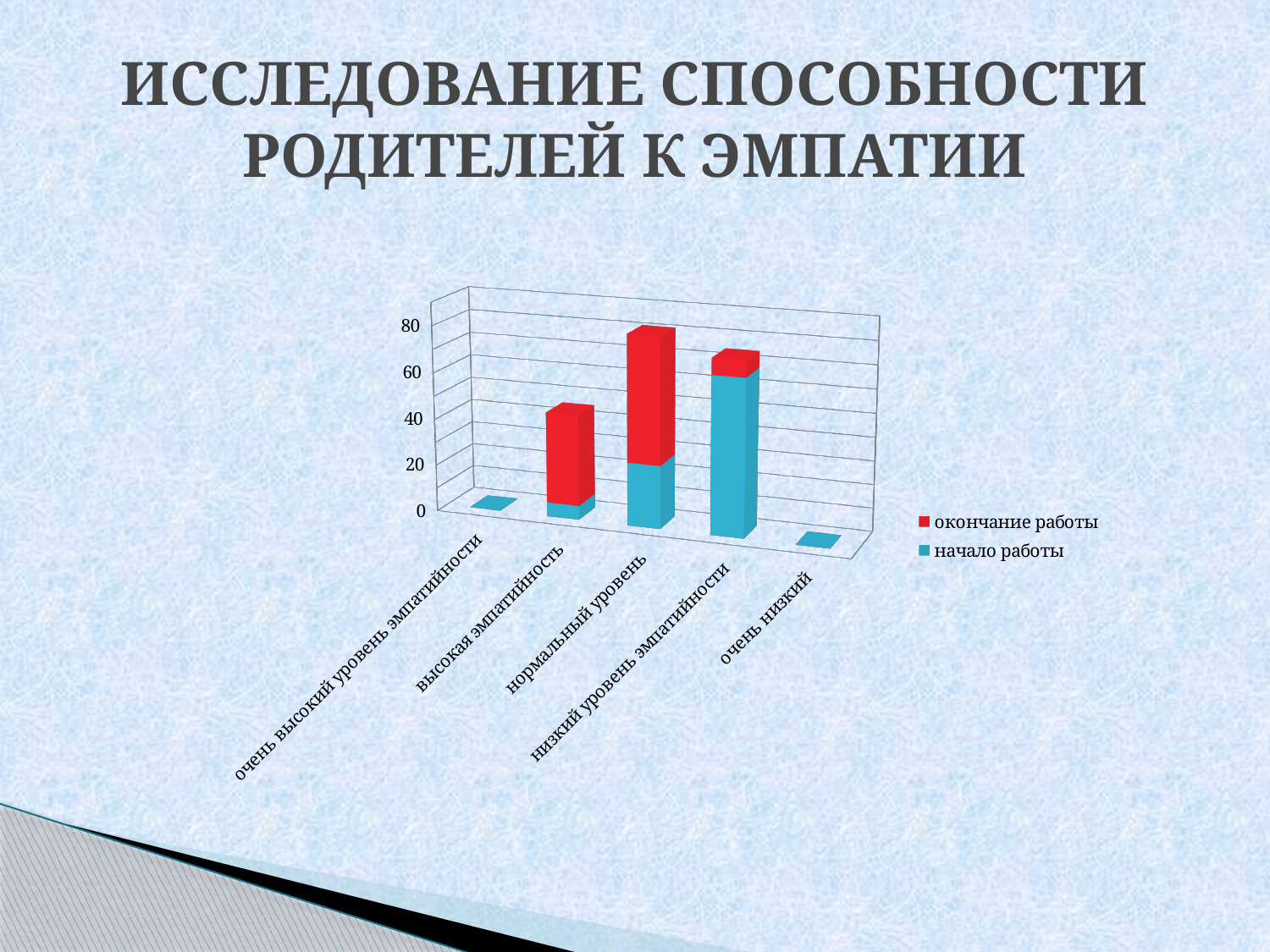
How many categories are shown on the x axis of the chart? 5 What colour represents the series 'начало работы' in the chart? blue How many series does the chart legend list? 2 Which category has the largest value for the series 'окончание работы'? нормальный уровень Which category has the largest value for the series 'начало работы'? низкий уровень эмпатийности Is the total stacked value for 'нормальный уровень' greater or less than 60? greater What kind of chart is shown on the slide? bar chart Which is larger: the 'начало работы' value for 'низкий уровень эмпатийности' or for 'нормальный уровень'? низкий уровень эмпатийности Which category has the tallest stacked bar? нормальный уровень Is the value of 'начало работы' for 'низкий уровень эмпатийности' greater or less than 40? greater Is the total stacked value for 'высокая эмпатийность' greater or less than 60? less Which is larger: the 'окончание работы' value for 'нормальный уровень' or for 'низкий уровень эмпатийности'? нормальный уровень